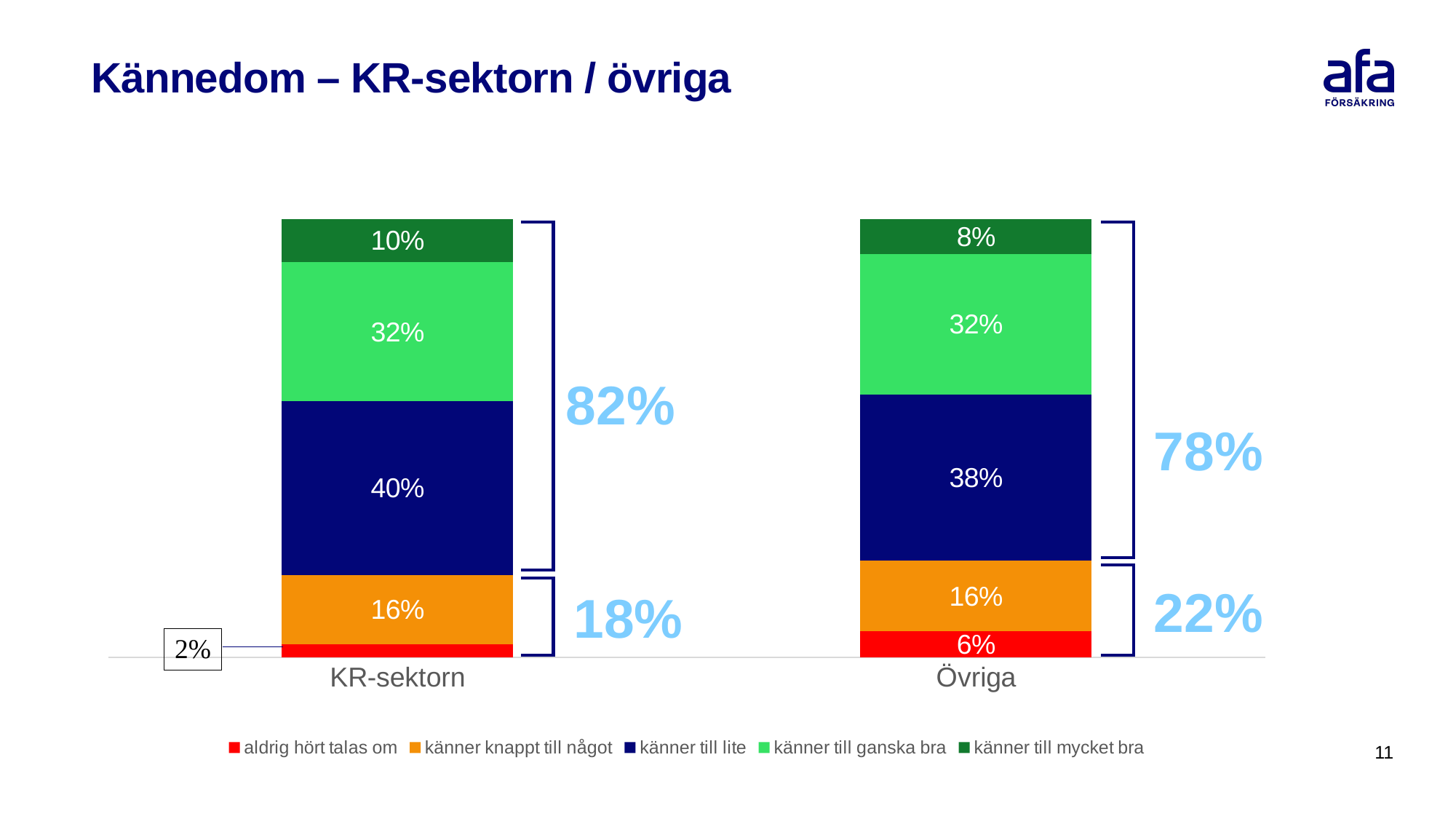
How many series does the legend list? 5 What is the value of "aldrig hört talas om" for Övriga? 6% Which segment is the largest in the Övriga bar? känner till lite What is the value of "känner till ganska bra" for Övriga? 32% What is the title of the slide? Kännedom – KR-sektorn / övriga What is the value of "känner till lite" for KR-sektorn? 40% Which segment is the smallest in the KR-sektorn bar? aldrig hört talas om What is the difference between the "känner till lite" values for KR-sektorn and Övriga? 2% Which category has the larger "aldrig hört talas om" value, KR-sektorn or Övriga? Övriga How many categories are shown on the x axis? 2 What kind of chart is shown on the slide? Stacked bar chart What is the value of "känner till mycket bra" for KR-sektorn? 10%